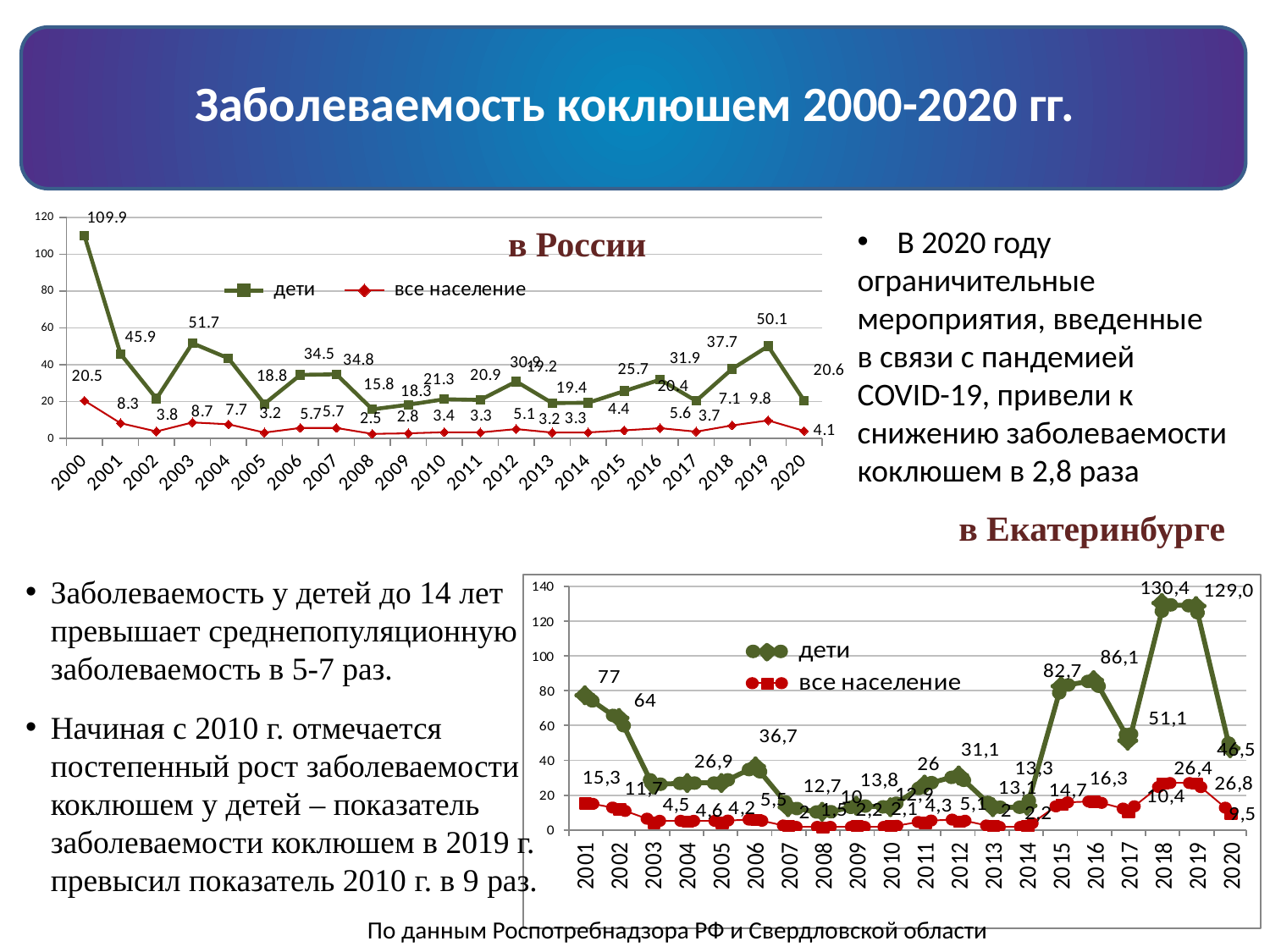
In the chart 'в России', what is the difference between the дети values for 2019 and 2020? 29.5 In the chart 'в России', what is the value for все население in 2020? 4.1 In the chart 'в России', is the value for дети in 2002 greater or less than 40? less In the chart 'в Екатеринбурге', which year has the highest value for дети? 2018 In the chart 'в России', which year has the highest value for дети? 2000 In the chart 'в Екатеринбурге', what is the value for все население in 2019? 26,8 In the chart 'в Екатеринбурге', what is the value for дети in 2018? 130,4 How many series does the legend of the chart 'в Екатеринбурге' list? 2 In the chart 'в Екатеринбурге', which is larger, the дети value for 2001 or for 2002? 2001 What kind of chart is the chart 'в России'? line chart In the chart 'в России', what is the value for дети in 2000? 109.9 In the chart 'в России', what is the value for дети in 2019? 50.1